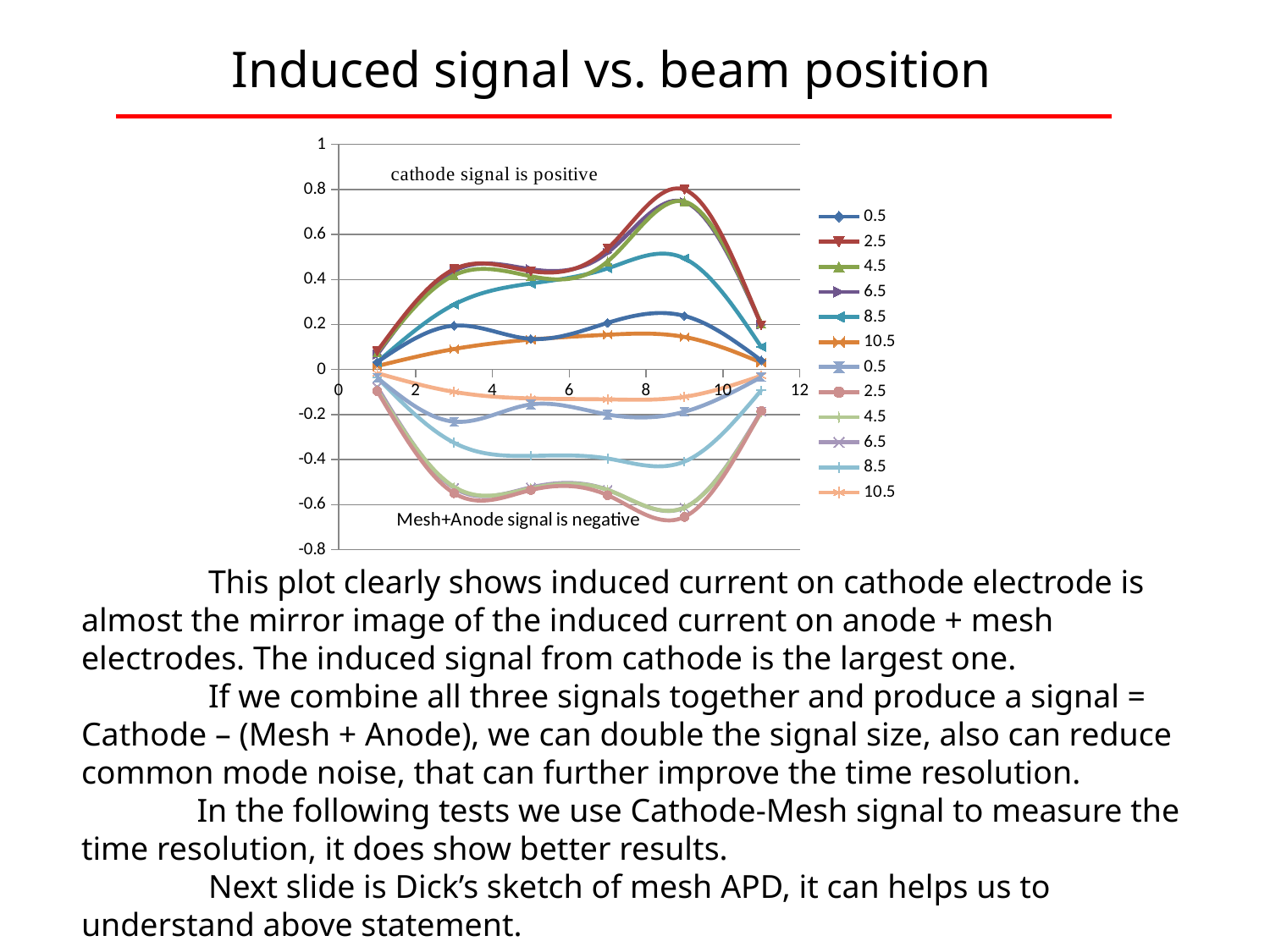
Is the value of the orange 10.5 series at x = 7 greater or less than 0.2? less Is the highest value of the blue diamond 0.5 series greater or less than 0.4? less How many data points are plotted for each series? 6 How many series does the legend list? 12 What is the title of the slide containing the chart? Induced signal vs. beam position According to the annotation in the upper part of the chart, which signal is positive? cathode signal What is the maximum value shown on the vertical axis? 1 What kind of chart is shown on the slide? line chart Is the peak value of the red 2.5 series (near x = 9) greater or less than 0.6? greater Does the red 2.5 series rise or fall between x = 9 and x = 11? fall